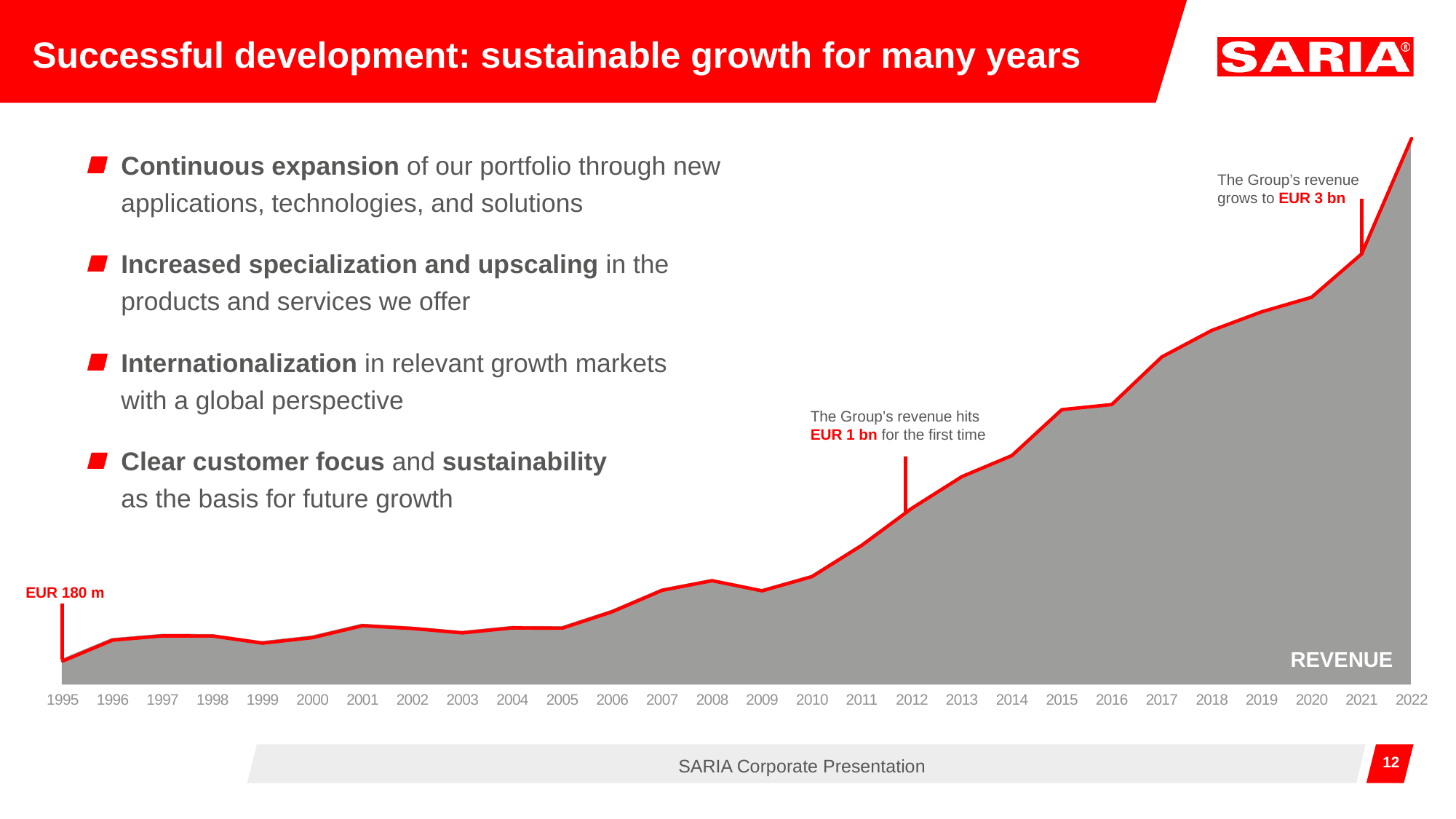
In which year did the Group's revenue grow to EUR 3 bn? 2021 Which year has higher revenue, 2012 or 2022? 2022 What type of chart is shown on the slide? Area chart Which year has higher revenue, 2008 or 2009? 2008 What is the name of the series plotted in the chart? REVENUE What was the Group's revenue in 1995 according to the chart? EUR 180 m Which year has the lowest revenue on the chart? 1995 By how much did the Group's revenue grow between the EUR 1 bn milestone in 2012 and the EUR 3 bn milestone in 2021? EUR 2 bn Which year has the highest revenue on the chart? 2022 In which year did the Group's revenue hit EUR 1 bn for the first time? 2012 Does revenue generally rise or fall from 1995 to 2022? Rise How many years are shown on the x axis of the chart? 28